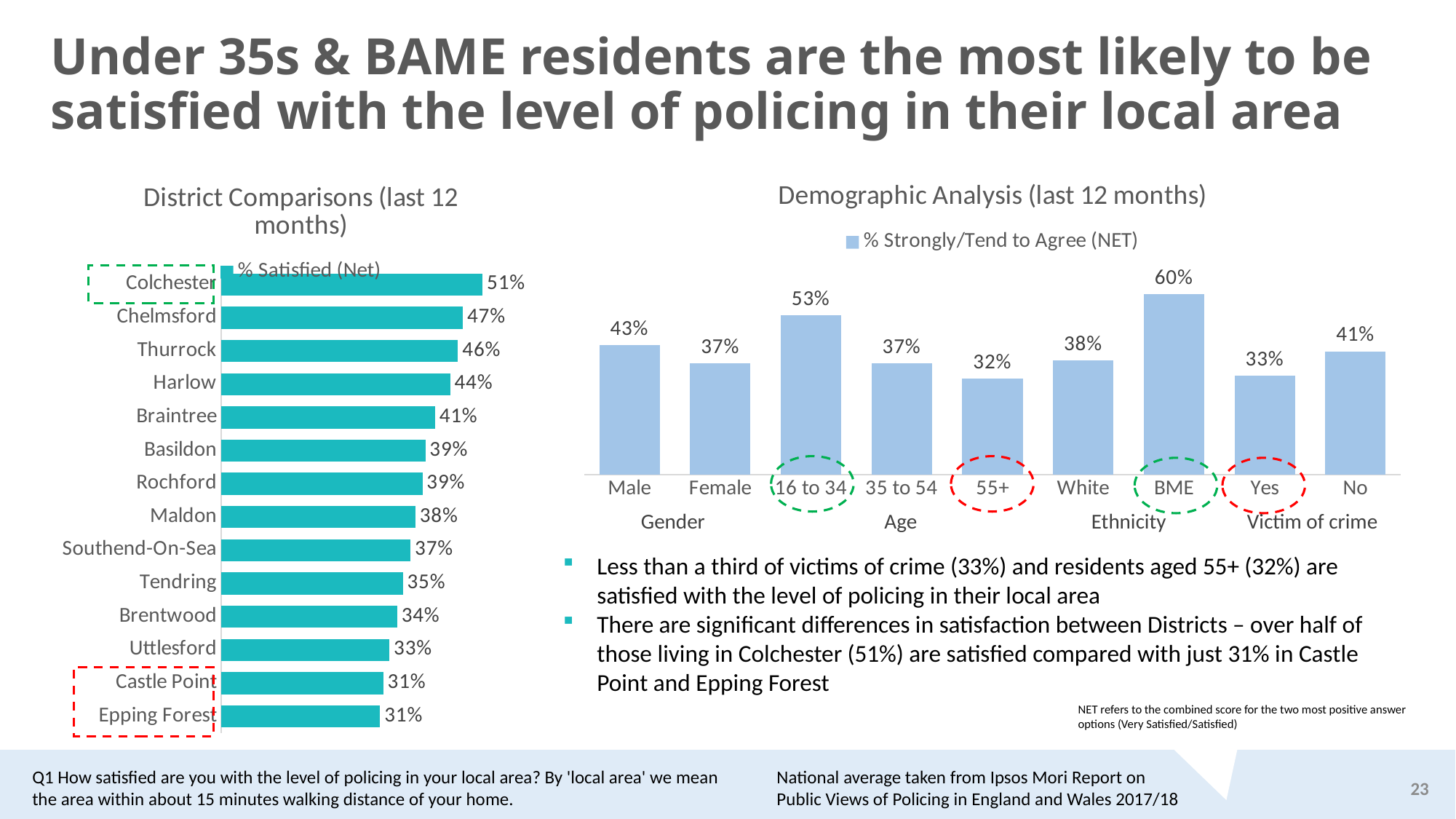
In the Demographic Analysis chart, what is the value for BME? 60% In the District Comparisons chart, what is the difference between Colchester and Uttlesford? 18% In the Demographic Analysis chart, what series name does the legend show? % Strongly/Tend to Agree (NET) In the District Comparisons chart, which is larger, Harlow or Braintree? Harlow In the Demographic Analysis chart, what is the difference between Male and Female? 6% In the District Comparisons chart, what is the % Satisfied (Net) for Thurrock? 46% In the Demographic Analysis chart, which category has the lowest value? 55+ In the District Comparisons chart, which district has the highest % Satisfied (Net)? Colchester What kind of chart is the Demographic Analysis chart? Bar chart In the District Comparisons chart, how many districts are shown? 14 In the Demographic Analysis chart, how many categories are plotted? 9 In the Demographic Analysis chart, which is larger, the value for Yes or the value for No under Victim of crime? No